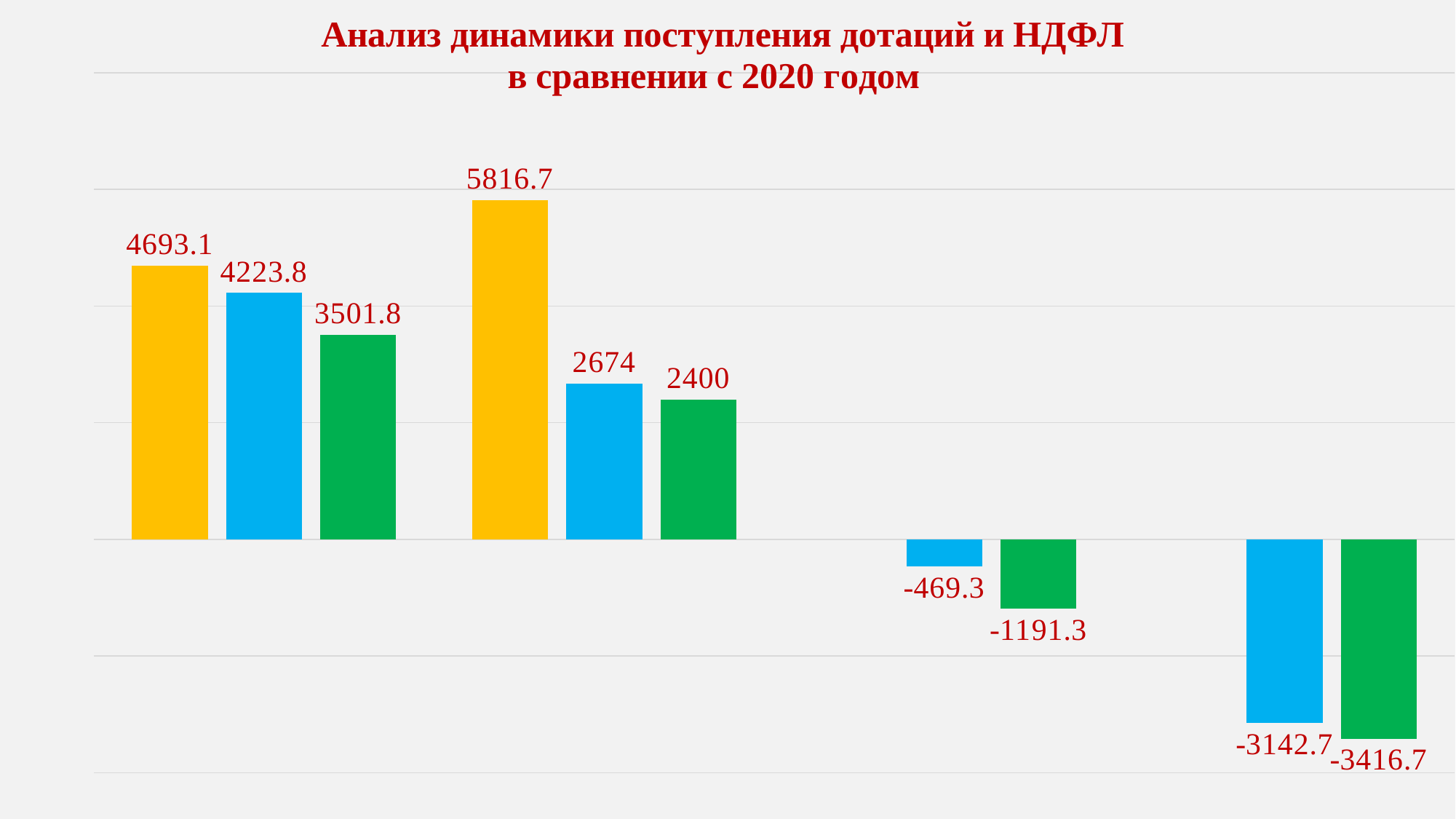
What is the value of the yellow bar in the second group of bars from the left? 5816.7 How many bars are plotted on the chart in total? 10 How many bars on the chart have negative values? 4 What is the highest value labelled on the chart? 5816.7 What is the lowest value labelled on the chart? -3416.7 In the first group of bars, which is larger: the blue bar or the green bar? the blue bar (4223.8) What kind of chart is shown on the slide? bar chart What is the value of the blue bar in the first (leftmost) group of bars? 4223.8 What is the difference between the yellow bar (5816.7) and the green bar (2400) in the second group? 3416.7 What is the difference between the yellow bar (4693.1) and the blue bar (4223.8) in the first group? 469.3 What is the value of the green bar in the third group of bars from the left? -1191.3 What is the title of the chart? Анализ динамики поступления дотаций и НДФЛ в сравнении с 2020 годом